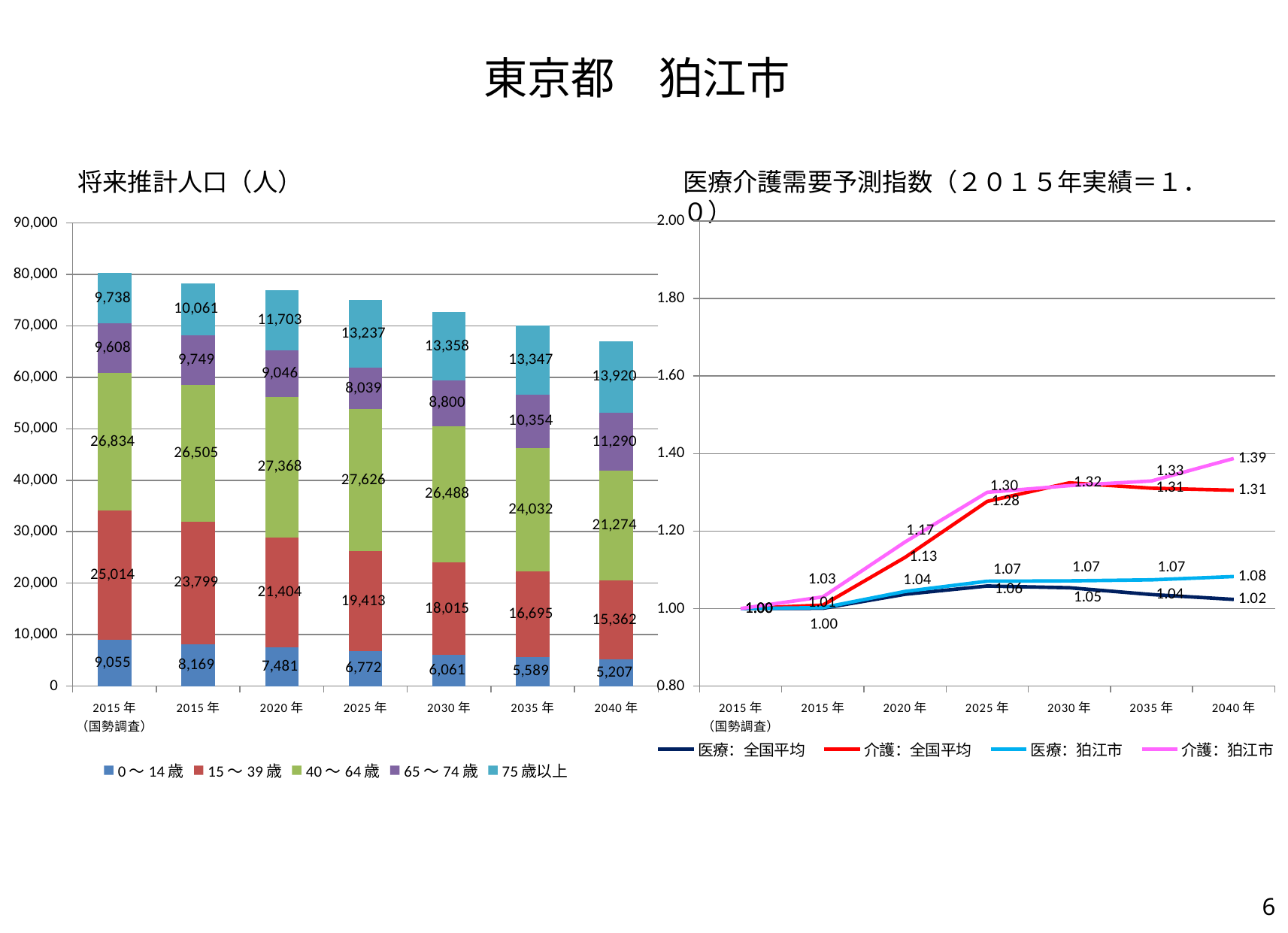
In the 医療介護需要予測指数 chart on the right, what is the value for 介護：狛江市 in 2040年? 1.39 In the 将来推計人口（人） chart, what is the value for 75歳以上 in 2040年? 13,920 In the 医療介護需要予測指数 chart on the right, which series has the highest value in 2040年? 介護：狛江市 In the 将来推計人口（人） chart, what is the total of the stacked bar for 2040年? 67,053 How many series does the legend of the 将来推計人口（人） chart list? 5 In the 将来推計人口（人） chart, what is the difference between the 75歳以上 value in 2040年 and in 2015年（国勢調査）? 4,182 In the 医療介護需要予測指数 chart on the right, which is larger in 2040年: 医療：狛江市 or 医療：全国平均? 医療：狛江市 How many series does the legend of the 医療介護需要予測指数 chart on the right list? 4 In the 将来推計人口（人） chart, does the total population rise or fall from 2015年（国勢調査） to 2040年? fall In the 将来推計人口（人） chart, which year has the lowest value for 0～14歳? 2040年 In the 将来推計人口（人） chart, what is the value for 15～39歳 in 2020年? 21,404 What kind of chart is the 将来推計人口（人） chart on the left? stacked bar chart